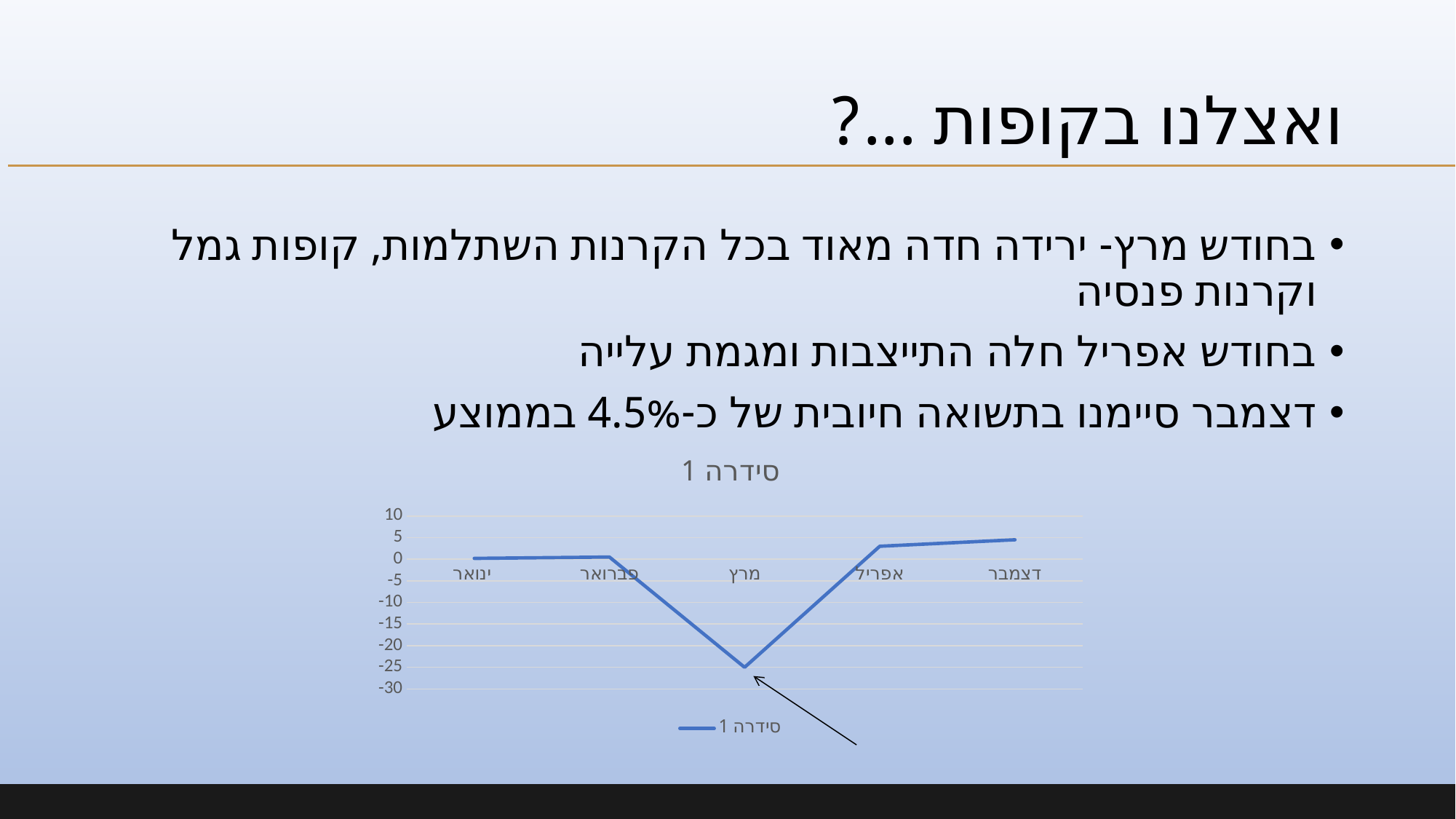
What is the title of the chart? סידרה 1 What kind of chart is shown on the slide? line chart Which has the larger value, מרץ or אפריל? אפריל What is the name of the series shown in the chart legend? סידרה 1 Does the line rise or fall from מרץ to דצמבר? rise Which category has the lowest value in the chart? מרץ Which category has the highest value in the chart? דצמבר Is the value for דצמבר greater or less than 0? greater Is the value for מרץ greater or less than -20? less How many categories are plotted along the x axis of the chart? 5 How many series does the chart legend list? 1 Is the value for ינואר greater or less than 5? less